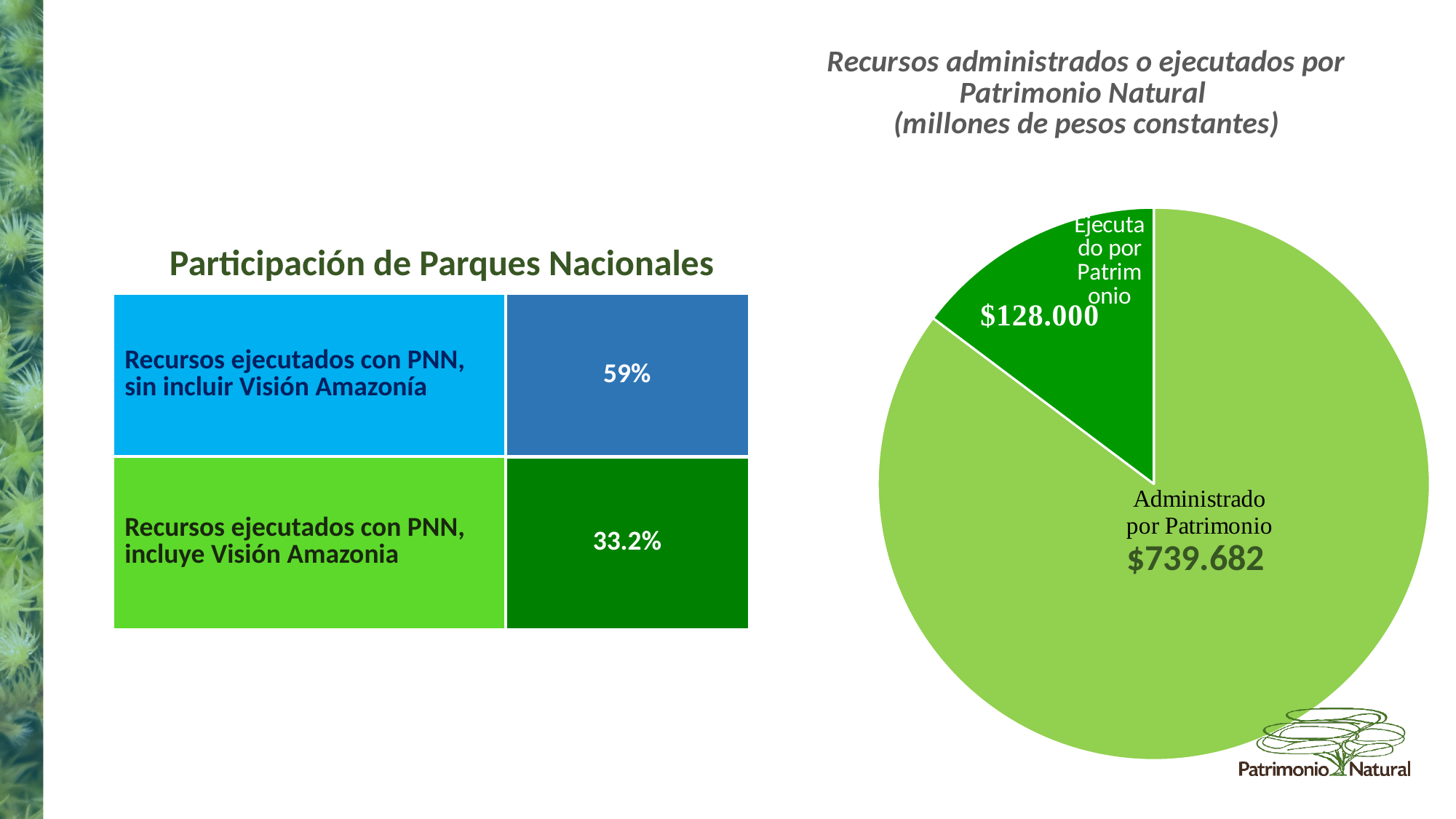
In the pie chart, what is the value for 'Ejecutado por Patrimonio'? $128.000 In the pie chart, what is the difference between 'Administrado por Patrimonio' and 'Ejecutado por Patrimonio'? $611.682 In the pie chart, which slice is the largest? Administrado por Patrimonio In the pie chart, what is the value for 'Administrado por Patrimonio'? $739.682 In the pie chart, which slice is the smallest? Ejecutado por Patrimonio In the pie chart, what is the total of the two slices? $867.682 In the pie chart, what colour is the 'Ejecutado por Patrimonio' slice? dark green In the pie chart, how many slices are there? 2 In the pie chart, which is larger: 'Administrado por Patrimonio' or 'Ejecutado por Patrimonio'? Administrado por Patrimonio What type of chart is shown on the right side of the slide? pie chart What is the title of the pie chart? Recursos administrados o ejecutados por Patrimonio Natural (millones de pesos constantes)